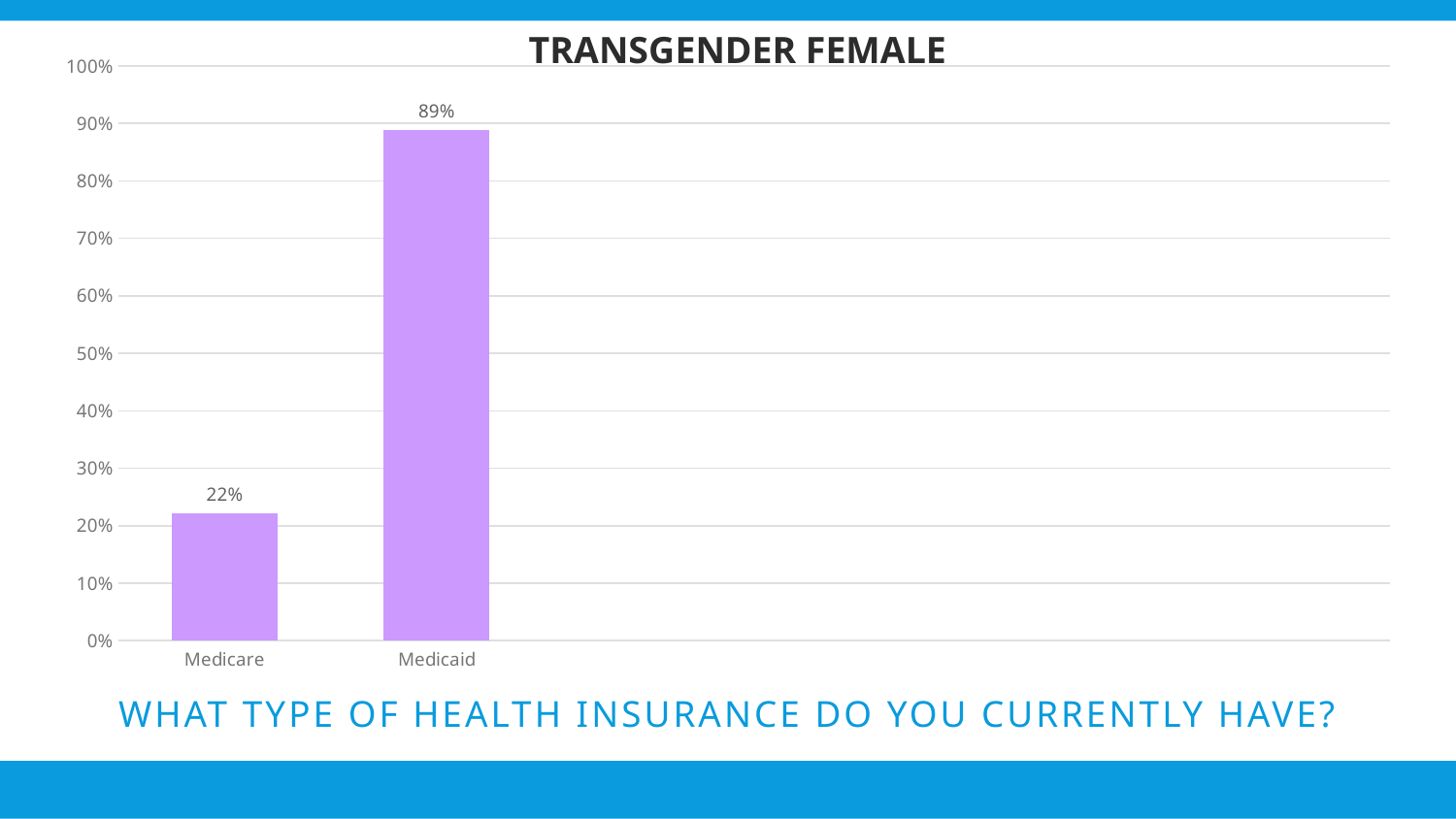
How many categories are shown on the x axis? 2 What is the value for Medicare? 22% What kind of chart is shown on the slide? bar chart Which category has the highest value? Medicaid What is the value for Medicaid? 89% What is the title of the chart? TRANSGENDER FEMALE What is the difference between the values for Medicaid and Medicare? 67% What is the maximum value shown on the y axis? 100% Is the value for Medicare greater or less than 30%? less Which category has the lowest value? Medicare Which is larger, the value for Medicare or the value for Medicaid? Medicaid Is the value for Medicaid greater or less than 80%? greater